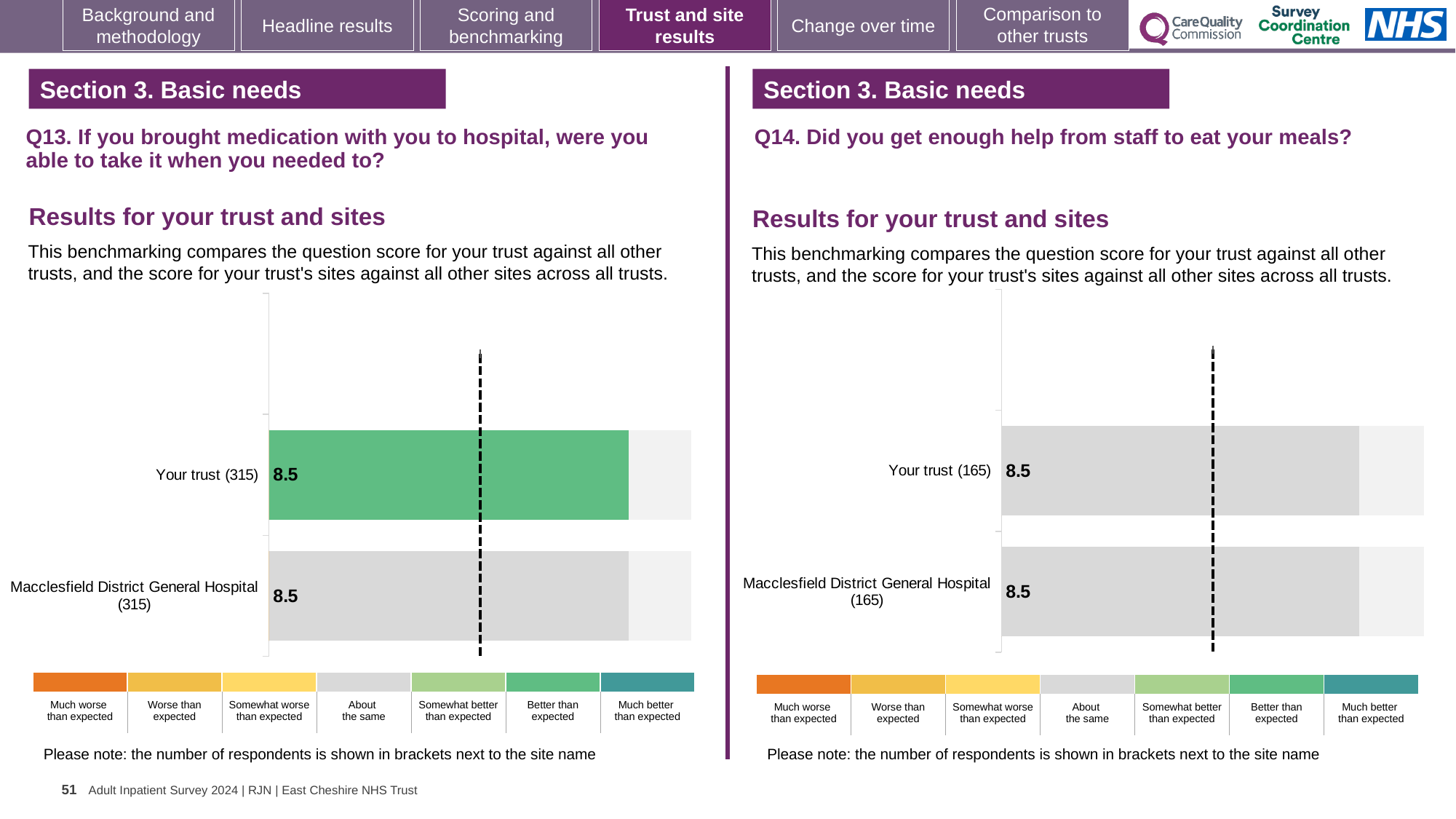
In the Q13 chart on the left, how many bars are plotted? 2 In the Q14 chart on the right, how many categories are plotted? 2 In the Q14 chart on the right, what is the score for Macclesfield District General Hospital? 8.5 In the Q14 chart on the right, what is the score for Your trust? 8.5 In the Q14 chart on the right, which benchmark category does the grey colour of the Your trust bar represent according to the legend? About the same In the Q13 chart on the left, which benchmark category does the green colour of the Your trust bar represent according to the legend? Better than expected In the Q13 chart on the left, what is the difference between the score for Your trust and the score for Macclesfield District General Hospital? 0 In the Q13 chart on the left, how many respondents are shown in brackets for Your trust? 315 What kind of chart is used for the Q13 results on the left? Bar chart In the Q13 chart on the left, what is the score for Your trust? 8.5 In the Q14 chart on the right, how many respondents are shown in brackets for Macclesfield District General Hospital? 165 In the Q13 chart on the left, what is the score for Macclesfield District General Hospital? 8.5